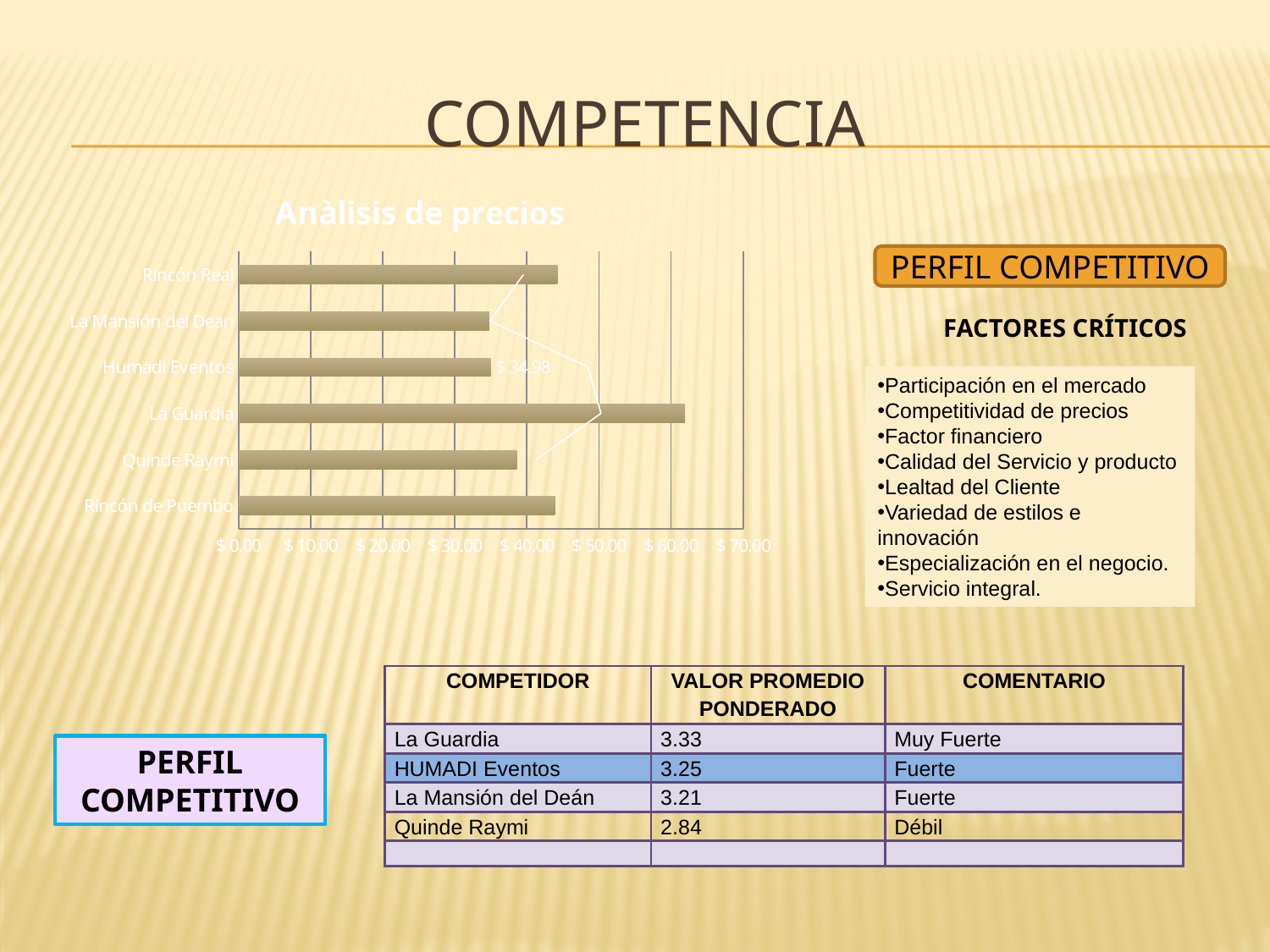
In the 'Anàlisis de precios' chart, is the value for Rincón de Puembo greater or less than $ 30.00? greater In the 'Anàlisis de precios' chart, is the value for La Guardia greater or less than $ 50.00? greater In the 'Anàlisis de precios' chart, what value is labelled for Humadi Eventos? $ 34.98 In the 'Anàlisis de precios' chart, which has the larger value, La Guardia or Rincón Real? La Guardia What kind of chart is the 'Anàlisis de precios' chart? bar chart In the 'Anàlisis de precios' chart, which competitor has the highest price? La Guardia In the 'Anàlisis de precios' chart, which has the larger value, Rincón Real or Quinde Raymi? Rincón Real What is the highest tick value shown on the horizontal axis of the 'Anàlisis de precios' chart? $ 70.00 In the 'Anàlisis de precios' chart, is the value for Rincón Real greater or less than $ 40.00? greater How many competitors are listed as categories in the 'Anàlisis de precios' chart? 6 What is the title of the chart on the slide? Anàlisis de precios